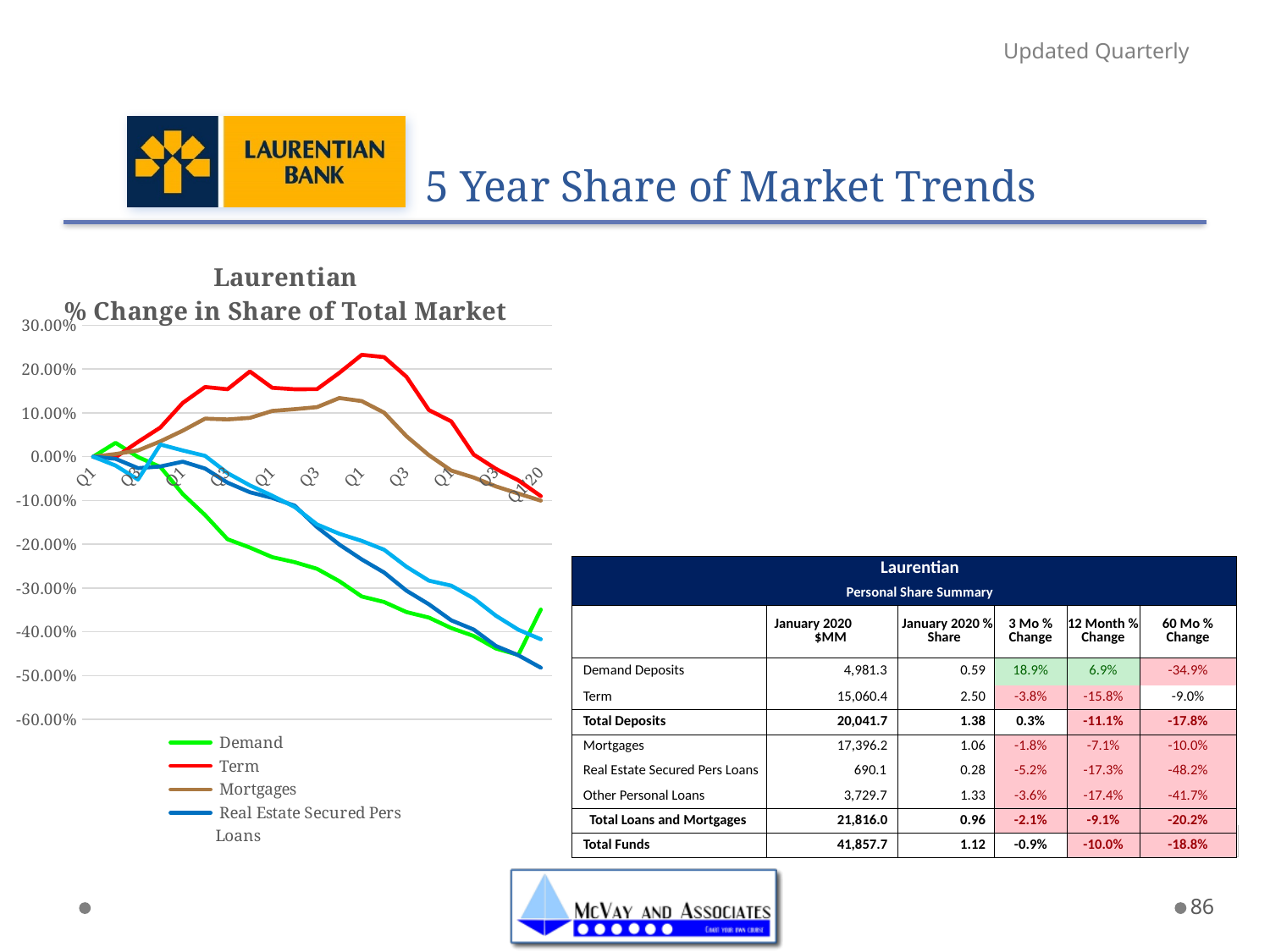
In the chart, which series reaches the highest value? Term Does the Demand line overall rise or fall from the first quarter to the last? fall Is the value of the Term line at the last point (Jan-20) greater or less than 0.00%? less What kind of chart is shown on the left of the slide? line chart What is the highest value shown on the chart's y axis? 30.00% What colour is the Demand line in the chart? green Is the peak value of the Term line greater or less than 20.00%? greater Is the peak value of the Mortgages line greater or less than 10.00%? greater How many series does the legend of the chart list? 4 At the last point on the x axis, which is higher: the Term line or the Demand line? Term What is the title of the chart on the left of the slide? Laurentian % Change in Share of Total Market